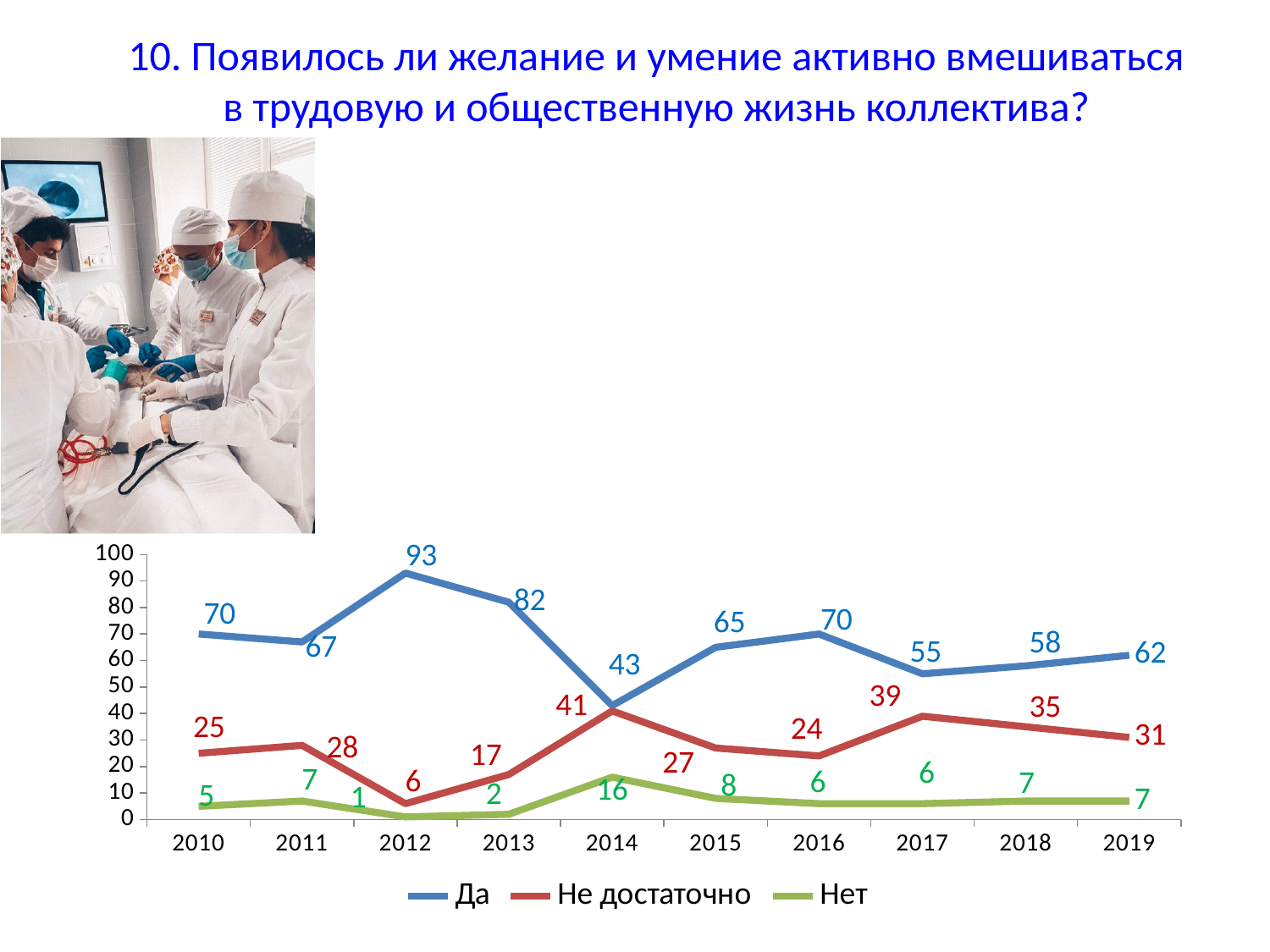
What is the value of the "Да" series in 2012? 93 In which year does the "Да" series have its lowest value? 2014 How many series does the legend list? 3 What is the value of the "Нет" series in 2019? 7 Which is larger in 2017: the "Да" value or the "Не достаточно" value? Да What is the difference between the "Да" value in 2012 and the "Да" value in 2014? 50 How many years are shown on the x axis? 10 What type of chart is shown on the slide? line chart In which year is the "Нет" series at its highest? 2014 In which year does the "Да" series reach its highest value? 2012 Does the "Да" series rise or fall from 2017 to 2019? rise What is the value of the "Не достаточно" series in 2014? 41